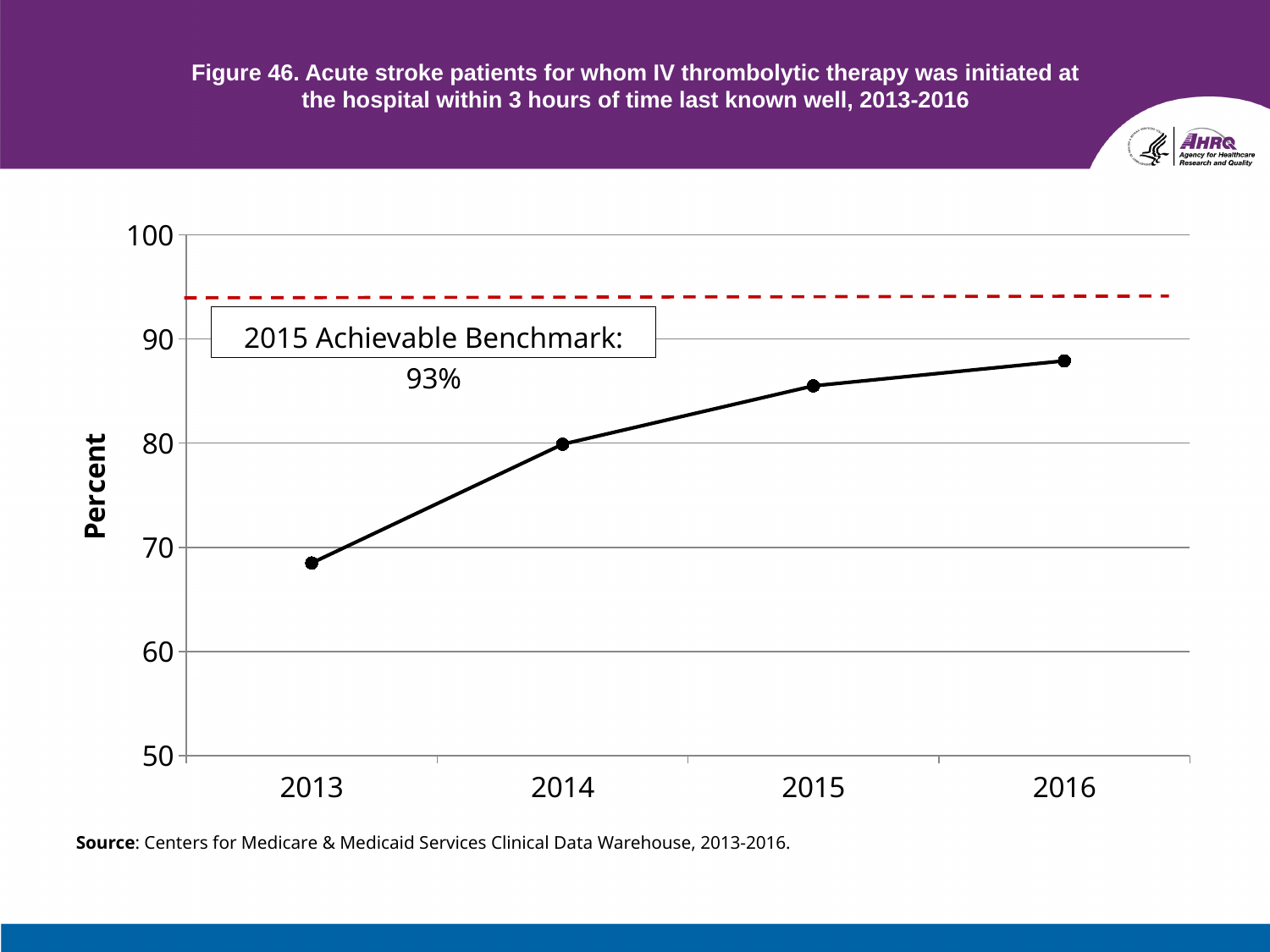
What is the 2015 Achievable Benchmark shown on the chart? 93% Which year has the larger value, 2013 or 2014? 2014 How many years are plotted on the x axis? 4 Is the value for 2014 greater or less than 70? greater Is the value for 2016 greater or less than 90? less Which year has the lowest percentage? 2013 What kind of chart is shown on the slide? line chart Which year has the highest percentage? 2016 What is the label on the y axis? Percent Is the value for 2015 greater or less than 80? greater Do the values rise or fall from 2013 to 2016? rise